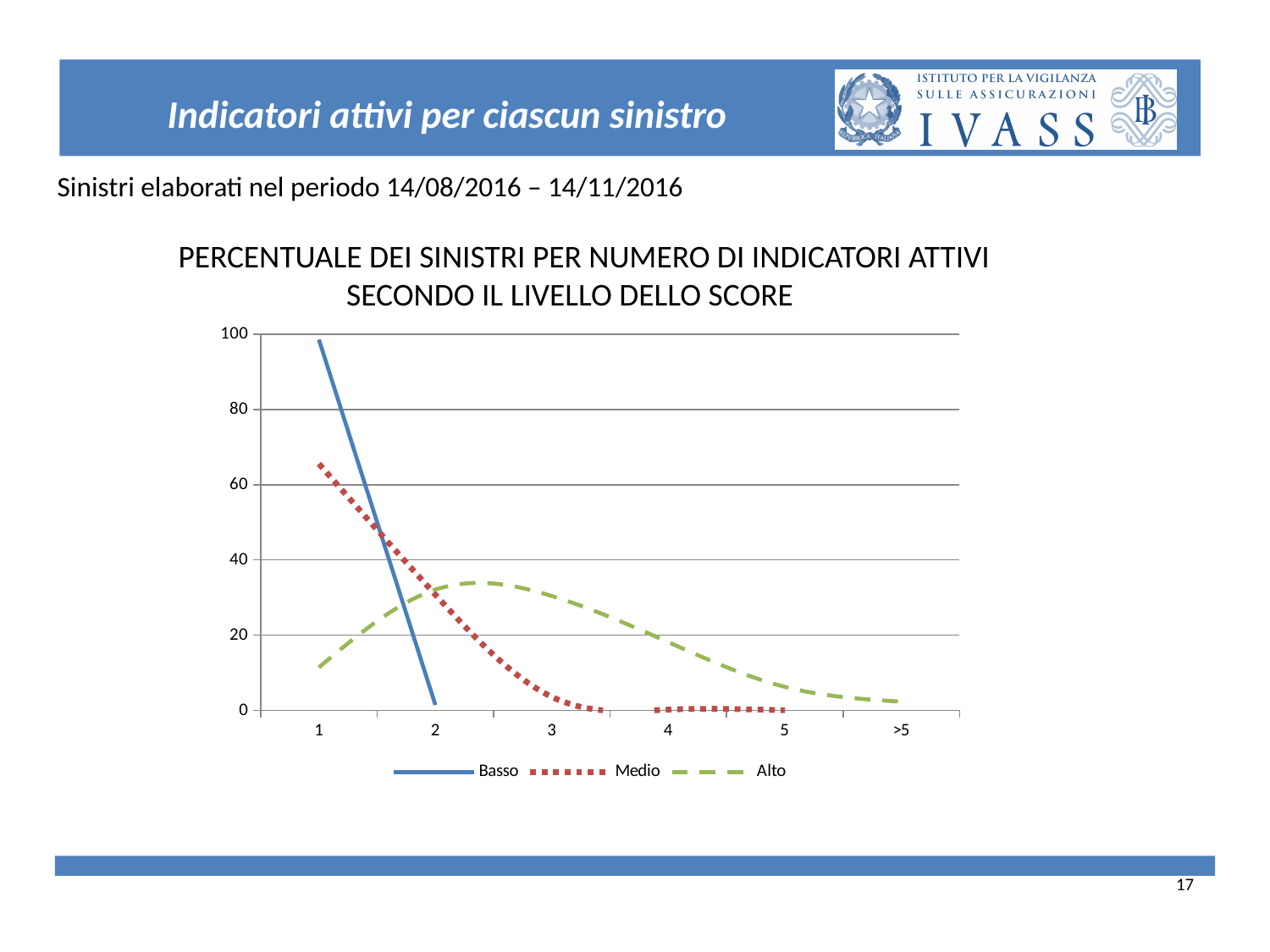
Is the value for Alto at 4 greater or less than 40? less Is the value for Alto at 1 greater or less than 20? less At category 2, which series has the larger value, Alto or Basso? Alto What are the three series listed in the legend? Basso, Medio, Alto Which series has the highest value at category 1? Basso How many series does the legend list? 3 What kind of chart is shown on the slide? line chart Does the Medio series rise or fall as the number of indicators increases from 1 to 5? fall At category 1, which series has the larger value, Basso or Medio? Basso How many categories are shown on the x axis? 6 Is the value for Medio at 2 greater or less than 40? less